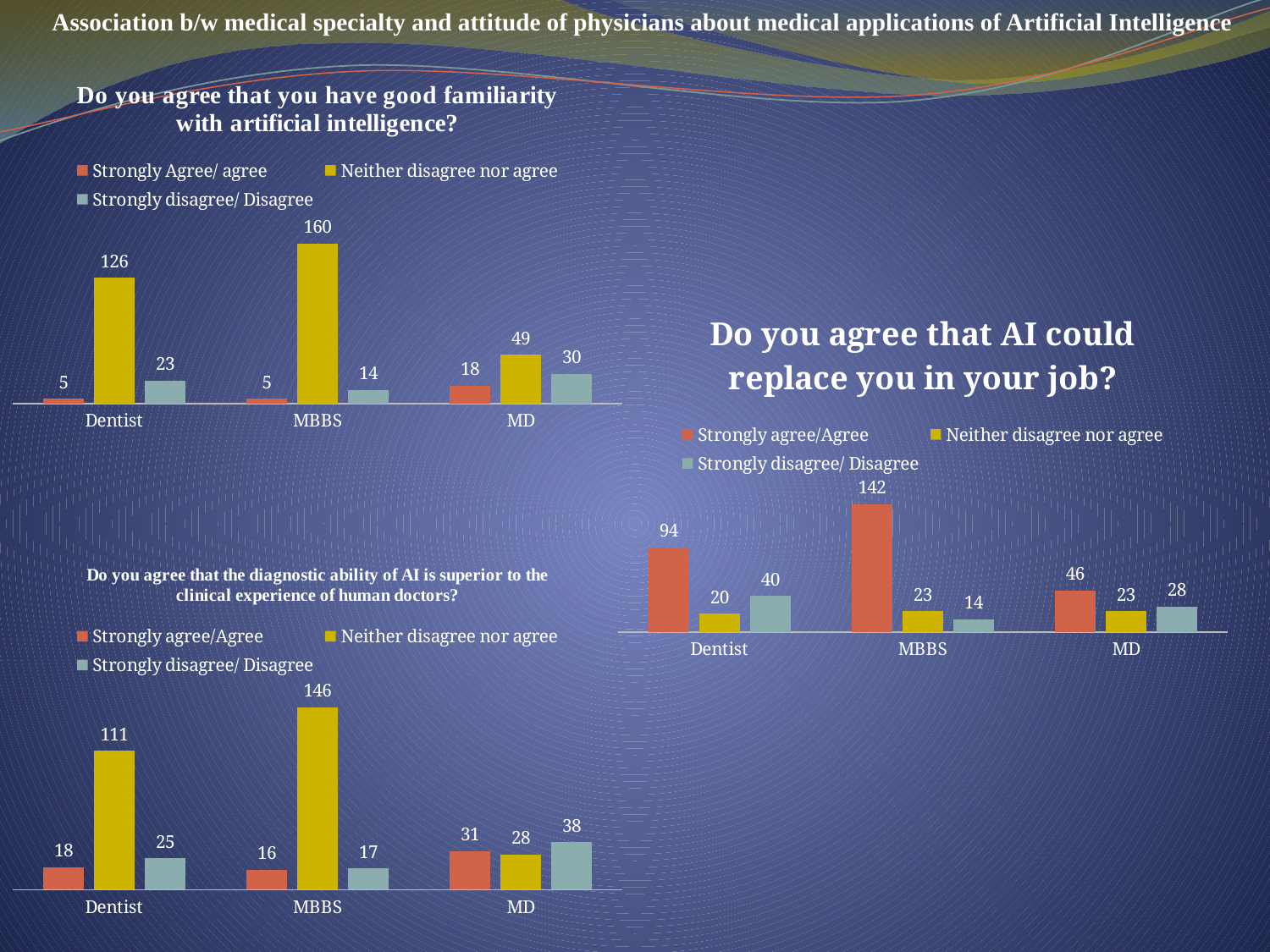
In the chart 'Do you agree that you have good familiarity with artificial intelligence?', what is the value for 'Neither disagree nor agree' for MBBS? 160 In the chart 'Do you agree that the diagnostic ability of AI is superior to the clinical experience of human doctors?', what is the total of the three values for MBBS? 179 In the chart 'Do you agree that AI could replace you in your job?', what is the value for 'Strongly agree/Agree' for MBBS? 142 What kind of chart is 'Do you agree that AI could replace you in your job?'? Bar chart In the chart 'Do you agree that the diagnostic ability of AI is superior to the clinical experience of human doctors?', what is the value for 'Neither disagree nor agree' for Dentist? 111 In the chart 'Do you agree that you have good familiarity with artificial intelligence?', what is the value for 'Strongly disagree/ Disagree' for Dentist? 23 In the chart 'Do you agree that AI could replace you in your job?', which category has the lowest 'Strongly disagree/ Disagree' value? MBBS How many series does the legend list in the chart 'Do you agree that AI could replace you in your job?'? 3 In the chart 'Do you agree that you have good familiarity with artificial intelligence?', which category has the highest 'Strongly Agree/ agree' value? MD In the chart 'Do you agree that the diagnostic ability of AI is superior to the clinical experience of human doctors?', which is larger for MD: 'Strongly agree/Agree' or 'Strongly disagree/ Disagree'? Strongly disagree/ Disagree How many categories are shown on the x axis of the chart 'Do you agree that you have good familiarity with artificial intelligence?'? 3 In the chart 'Do you agree that AI could replace you in your job?', what is the difference between the 'Strongly agree/Agree' values for MBBS and Dentist? 48